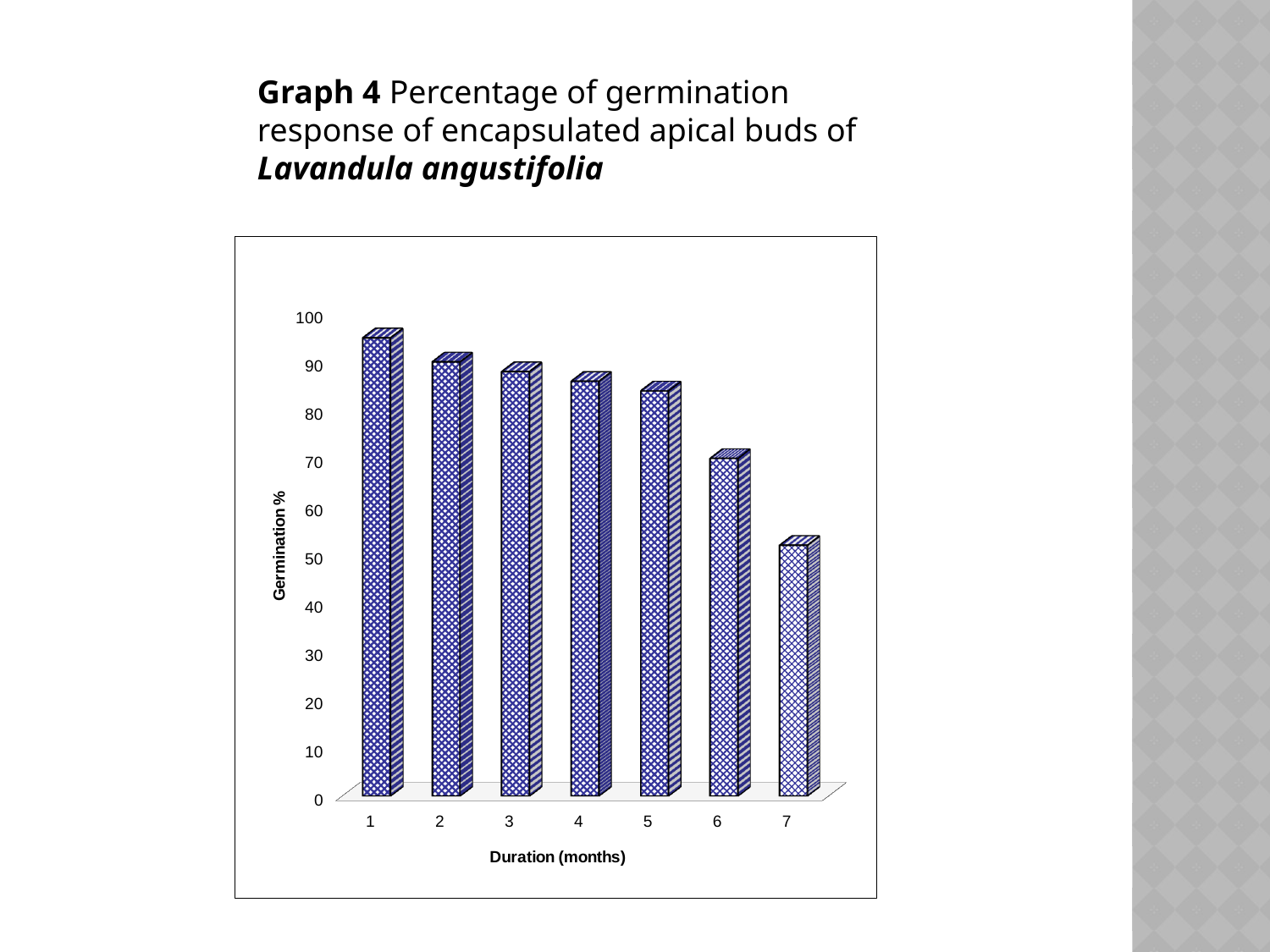
How many duration categories are plotted on the x axis? 7 Which has a higher germination %: 2 months or 6 months? 2 months Is the germination % at 7 months greater or less than 60? less Is the germination % at 6 months greater or less than 80? less Which duration (months) has the lowest germination %? 7 What kind of chart is shown on the slide? bar chart Does the germination % rise or fall as the duration in months increases? fall Is the germination % at 5 months greater or less than 80? greater Which duration (months) has the highest germination %? 1 What is the label of the x axis? Duration (months) What is the label of the y axis? Germination %